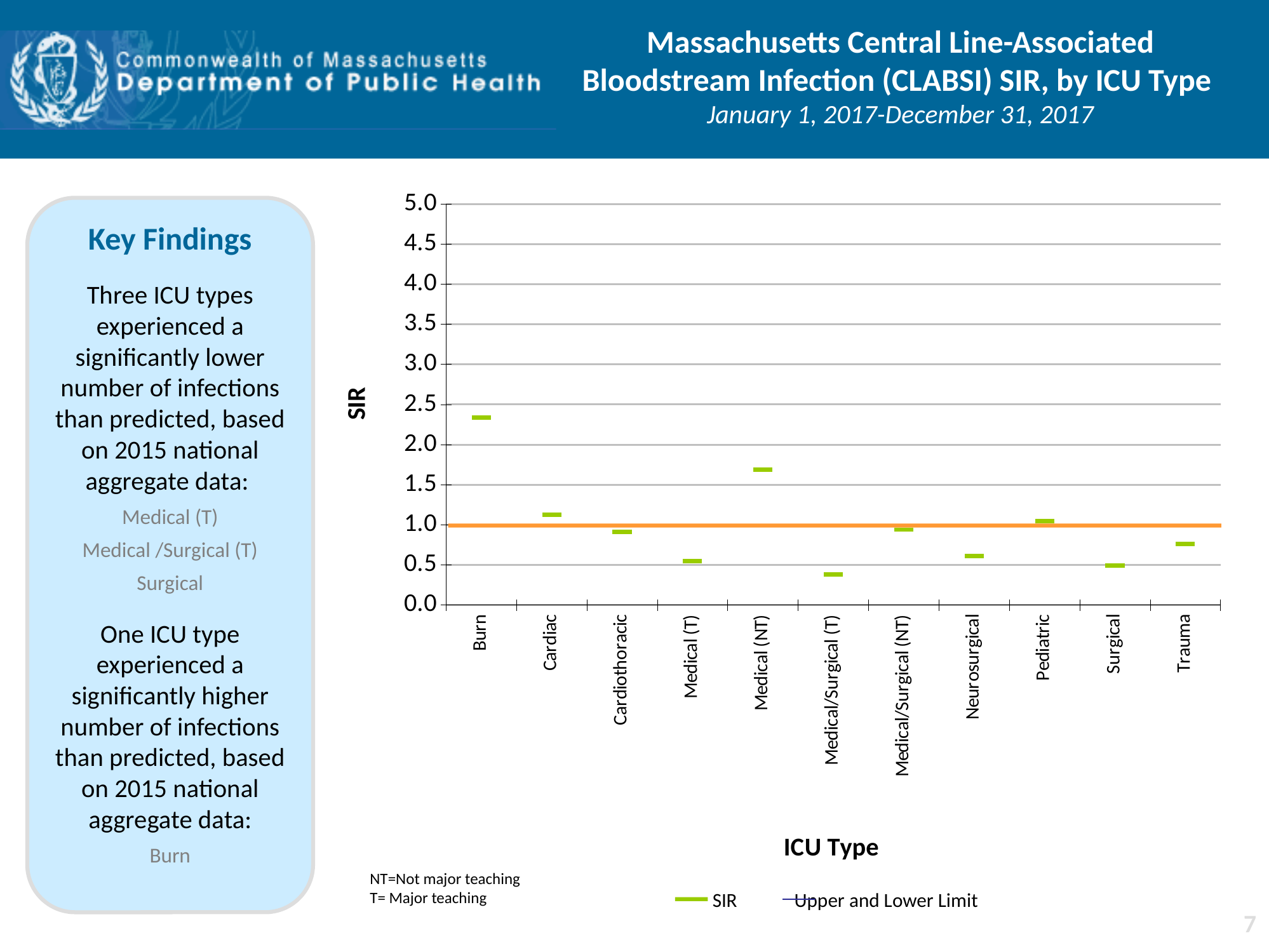
How many ICU types are plotted along the x axis of the chart? 11 Which has the larger SIR, Burn or Medical (NT)? Burn Is the SIR for Medical/Surgical (T) greater or less than 0.5? less Which ICU type has the highest SIR in the chart? Burn Is the SIR for Trauma greater or less than 1.0? less Which has the larger SIR, Surgical or Trauma? Trauma Is the SIR for Medical (T) greater or less than 1.0? less How many series does the chart legend list? 2 What is the title of the chart's y axis? SIR Which ICU type has the lowest SIR in the chart? Medical/Surgical (T)